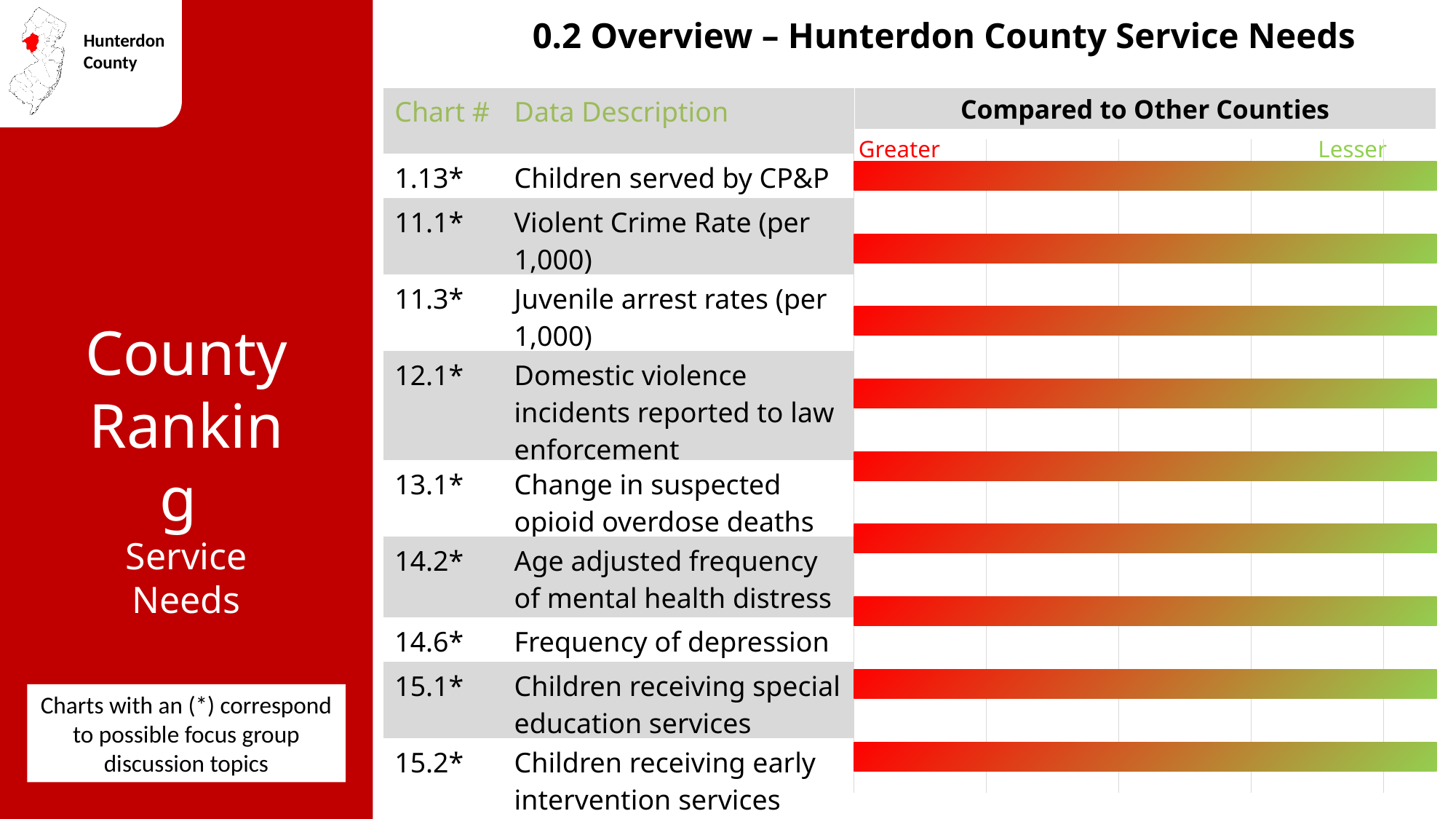
What kind of chart is shown under "Compared to Other Counties"? bar chart What label appears at the left end of the chart's scale? Greater Which chart number corresponds to "Frequency of depression"? 14.6* What data description is listed for chart 15.2*? Children receiving early intervention services How many data descriptions are listed in the table next to the chart? 9 Which chart number corresponds to "Children served by CP&P"? 1.13* How many horizontal bars are plotted in the "Compared to Other Counties" chart? 9 What data description is listed for chart 13.1*? Change in suspected opioid overdose deaths What is the title of the chart on the right side of the slide? Compared to Other Counties What label appears at the right end of the chart's scale? Lesser